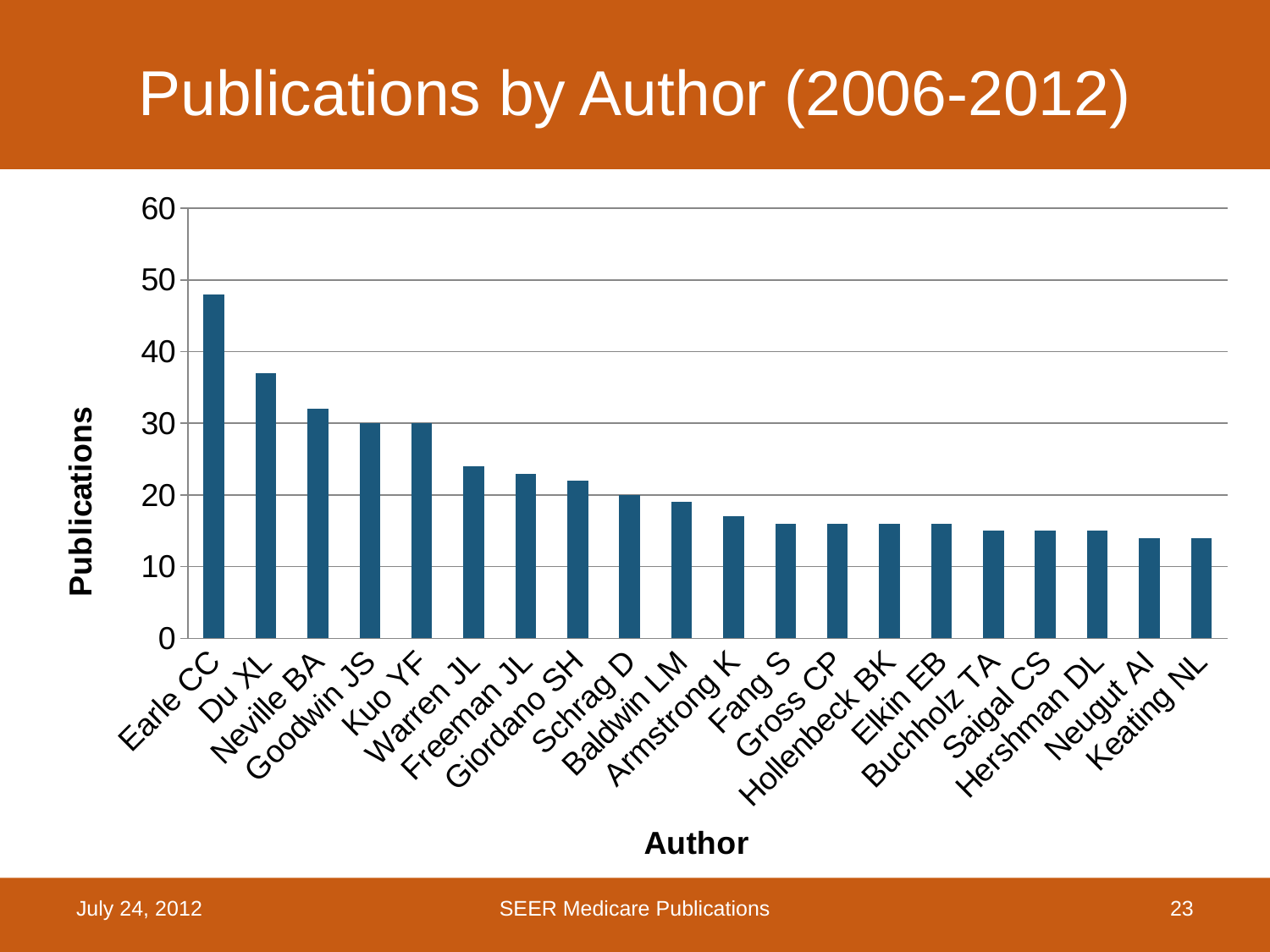
Is the value for Earle CC greater or less than 40? greater Is the value for Du XL greater or less than 40? less Do the values rise or fall moving from left to right along the x axis? fall Which has more publications, Du XL or Neville BA? Du XL Is the value for Fang S greater or less than 20? less How many authors are shown on the x axis? 20 Which author has the highest number of publications? Earle CC What is the title of the chart? Publications by Author (2006-2012) What is the label on the vertical axis? Publications What kind of chart is shown on the slide? bar chart